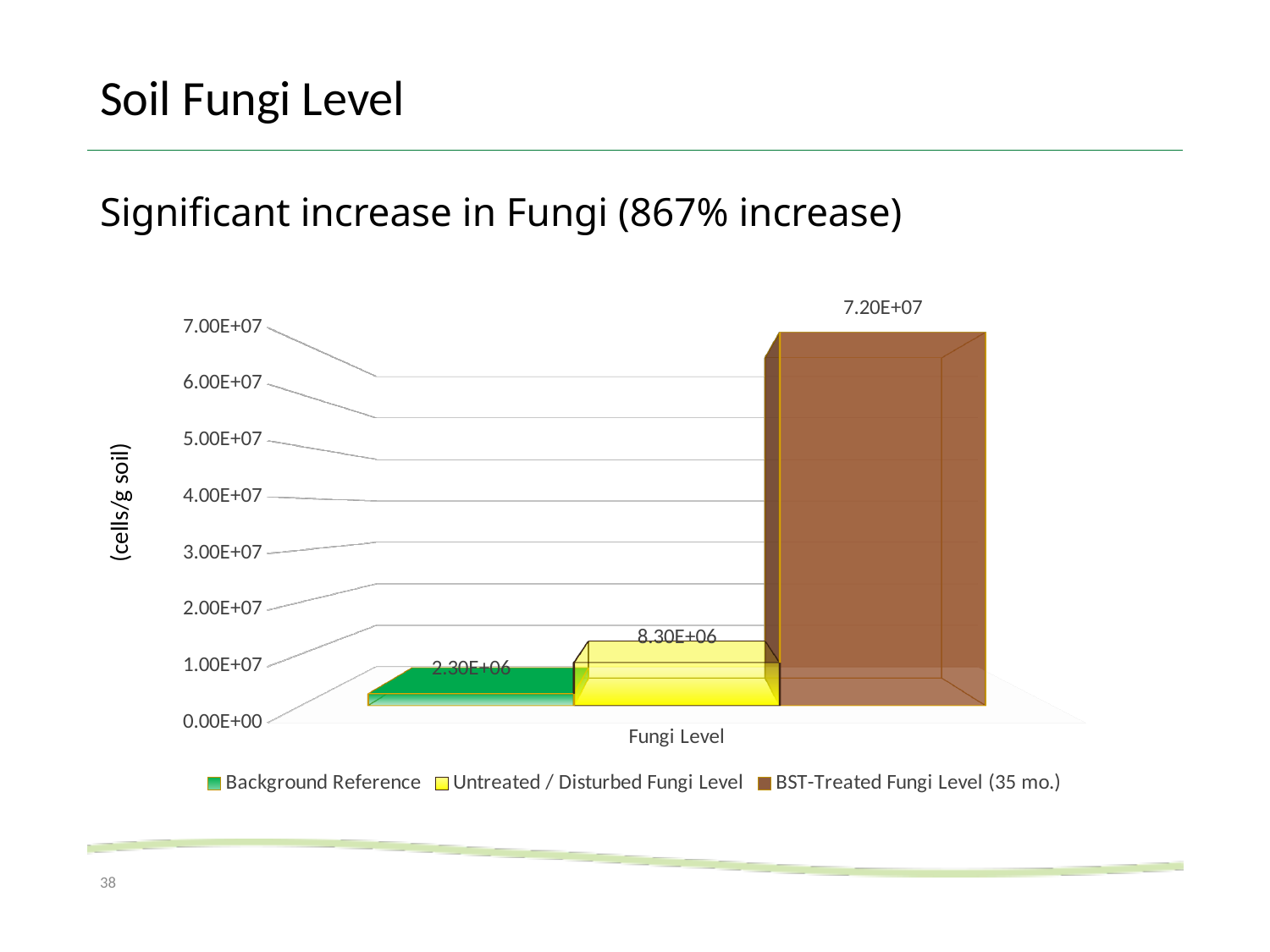
What kind of chart is shown on the slide? Bar chart Is the value for BST-Treated Fungi Level (35 mo.) greater or less than 5.00E+07? greater What is the value for the Background Reference series? 2.30E+06 Which series has the lowest value? Background Reference What is the value for the BST-Treated Fungi Level (35 mo.) series? 7.20E+07 What is the difference between the Untreated / Disturbed Fungi Level and the Background Reference? 6.00E+06 How many series does the legend list? 3 What is the label on the vertical axis of the chart? (cells/g soil) What is the value for the Untreated / Disturbed Fungi Level series? 8.30E+06 Is the value for Untreated / Disturbed Fungi Level greater or less than 1.00E+07? less Which is larger, the Untreated / Disturbed Fungi Level or the Background Reference? Untreated / Disturbed Fungi Level Which series has the highest value? BST-Treated Fungi Level (35 mo.)